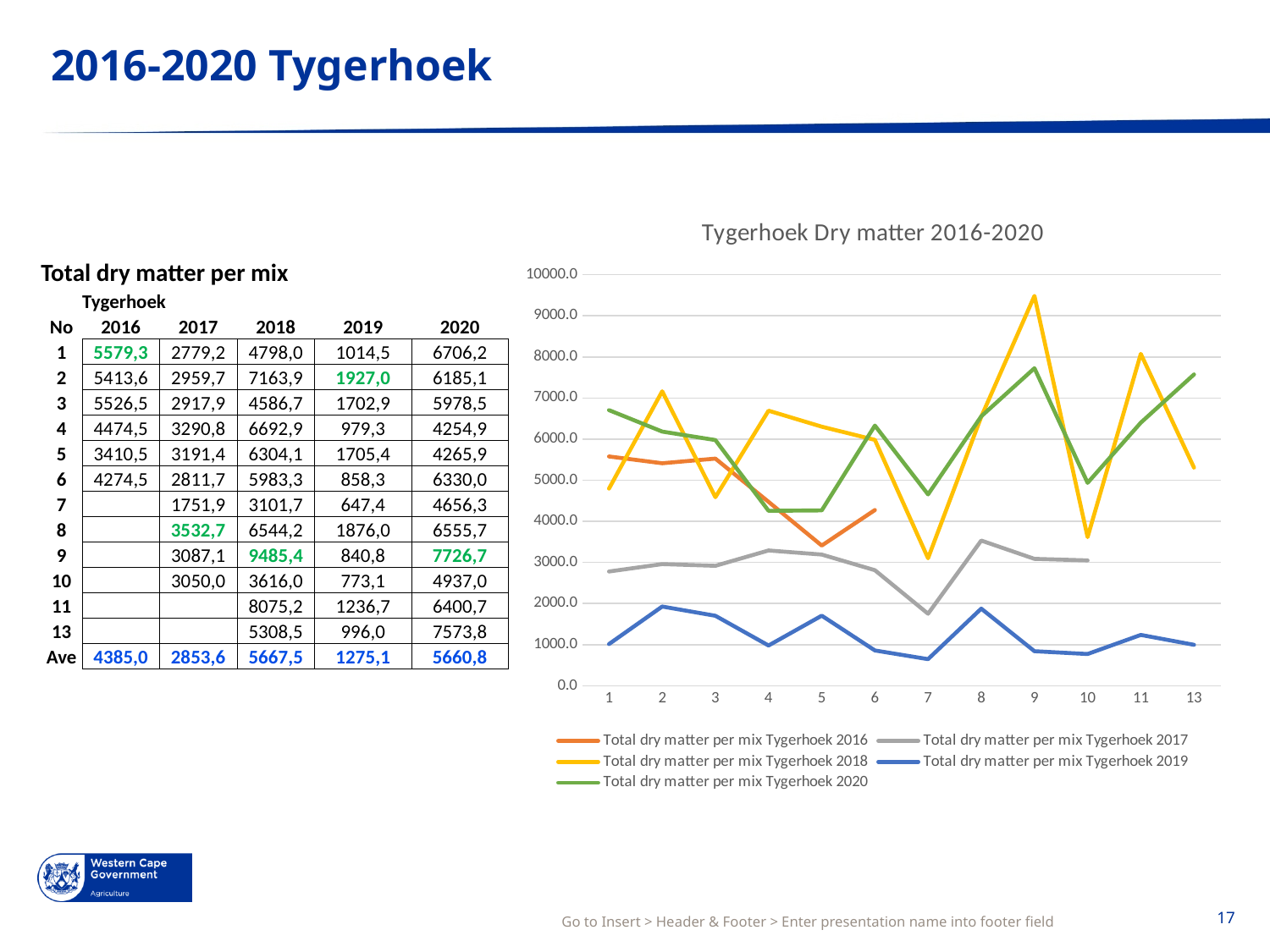
What is the value of the 2018 series at mix 9? 9485,4 At mix 9, which series is larger, 2018 or 2020? 2018 What kind of chart is shown on the slide? line chart Is the value of the 2017 series at mix 7 greater or less than 2000? less Which series reaches the highest point on the chart? Total dry matter per mix Tygerhoek 2018 How many series does the chart legend list? 5 Does the 2016 series rise or fall from mix 3 to mix 5? fall What is the value of the 2016 series at mix 1? 5579,3 How many mix numbers are shown along the x axis of the chart? 12 What is the title of the chart? Tygerhoek Dry matter 2016-2020 Is the value of the 2020 series at mix 9 greater or less than 7000? greater Which series has the lowest values across the chart? Total dry matter per mix Tygerhoek 2019